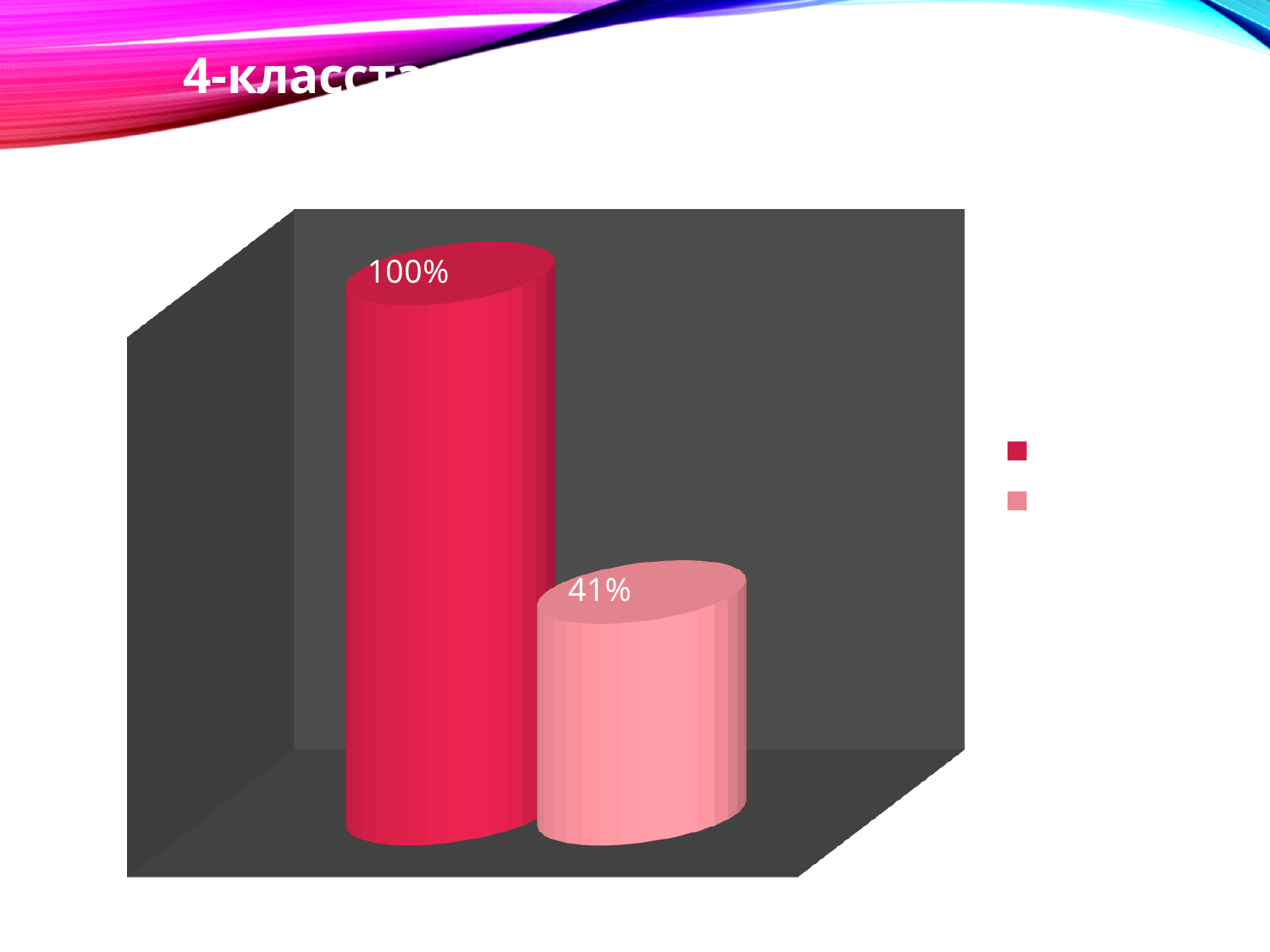
Which bar has the highest value, the dark red one or the light pink one? the dark red bar How many bars are plotted on the chart? 2 Is the value of the left bar larger or smaller than the value of the right bar? larger Is the chart drawn in 3D or flat 2D? 3D What kind of chart is shown on the slide? bar chart What value is labelled on the taller, dark red bar? 100% Which bar has the lowest value, the dark red one or the light pink one? the light pink bar How many entries does the legend show? 2 What is the difference between the values of the dark red bar and the light pink bar? 59% What value is labelled on the shorter, light pink bar? 41% Do the values fall or rise from the left bar to the right bar? fall What colour is the bar labelled 41%? light pink